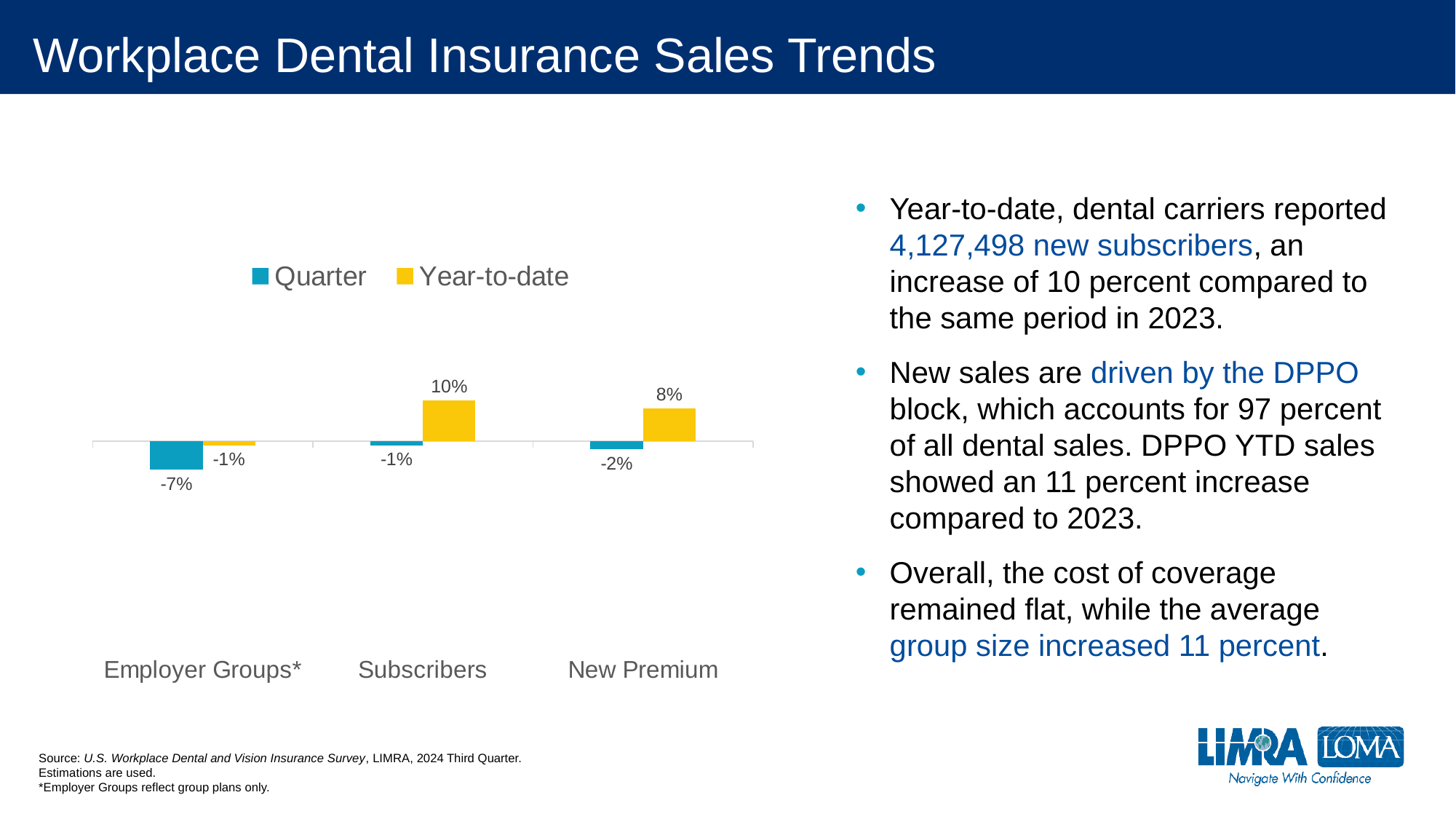
What kind of chart is shown on the slide? Bar chart How many categories are shown on the x axis of the chart? 3 Which category has the lowest Quarter value? Employer Groups* What is the Quarter value for New Premium? -2% What is the difference between the Year-to-date values for Subscribers and New Premium? 2 percentage points Which category has the highest Year-to-date value? Subscribers How many series does the chart legend list? 2 What is the Year-to-date value for New Premium? 8% Which is larger, the Quarter value for Subscribers or the Quarter value for Employer Groups*? Subscribers What is the Year-to-date value for Employer Groups*? -1% What is the Quarter value for Employer Groups*? -7% What is the Year-to-date value for Subscribers? 10%